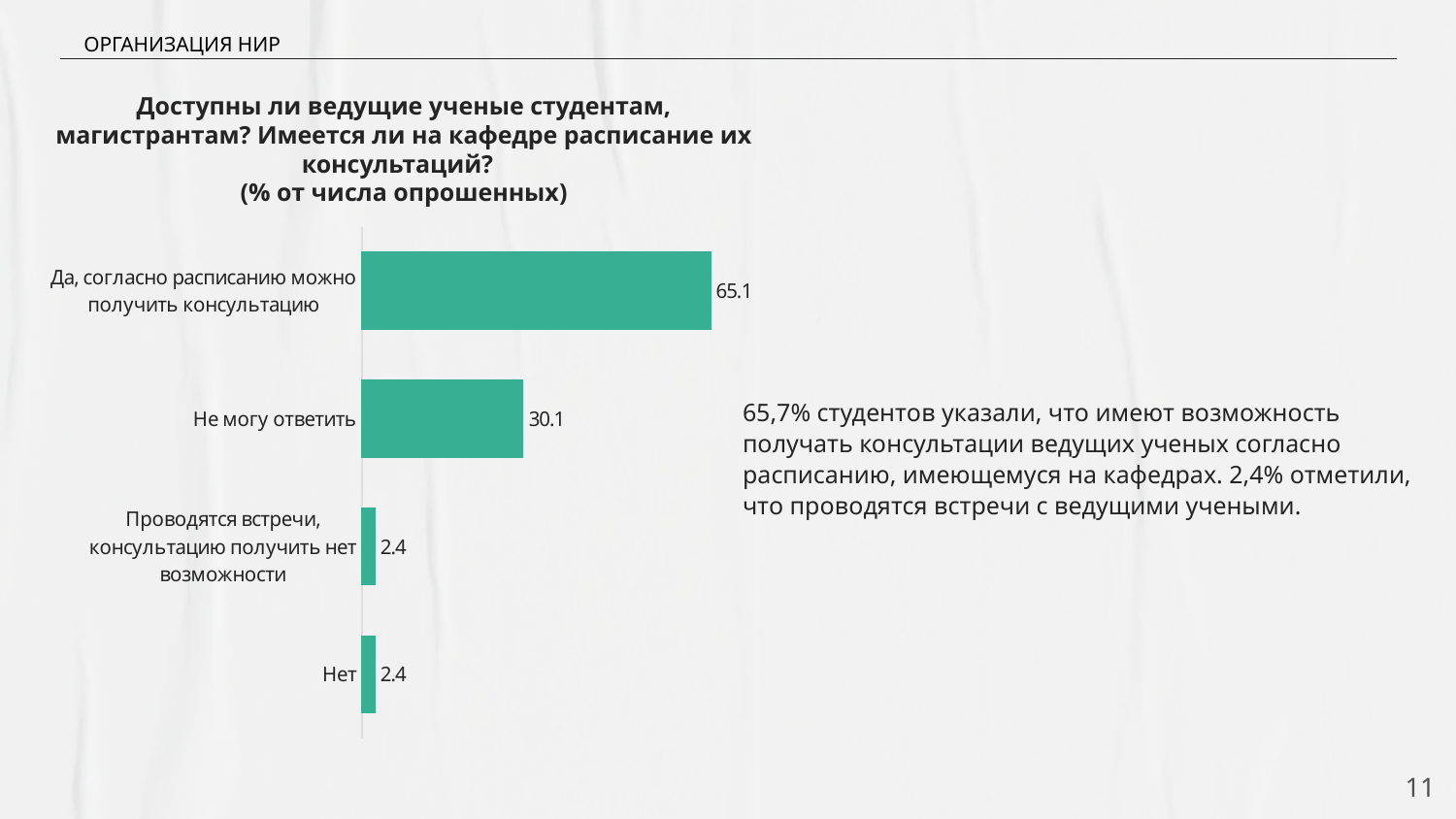
What type of chart is shown on the slide? Bar chart What is the total of the values for "Проводятся встречи, консультацию получить нет возможности" and "Нет"? 4.8 What unit does the chart title say the values are expressed in? % от числа опрошенных What value is shown for "Проводятся встречи, консультацию получить нет возможности"? 2.4 What is the difference between the values for "Не могу ответить" and "Нет"? 27.7 What is the difference between the values for "Да, согласно расписанию можно получить консультацию" and "Не могу ответить"? 35 What value is shown for the category "Не могу ответить"? 30.1 What value is shown for the category "Нет"? 2.4 Which category has the highest value in the chart? Да, согласно расписанию можно получить консультацию How many categories are shown in the chart? 4 What value is shown for the category "Да, согласно расписанию можно получить консультацию"? 65.1 Which is larger: the value for "Не могу ответить" or the value for "Нет"? Не могу ответить